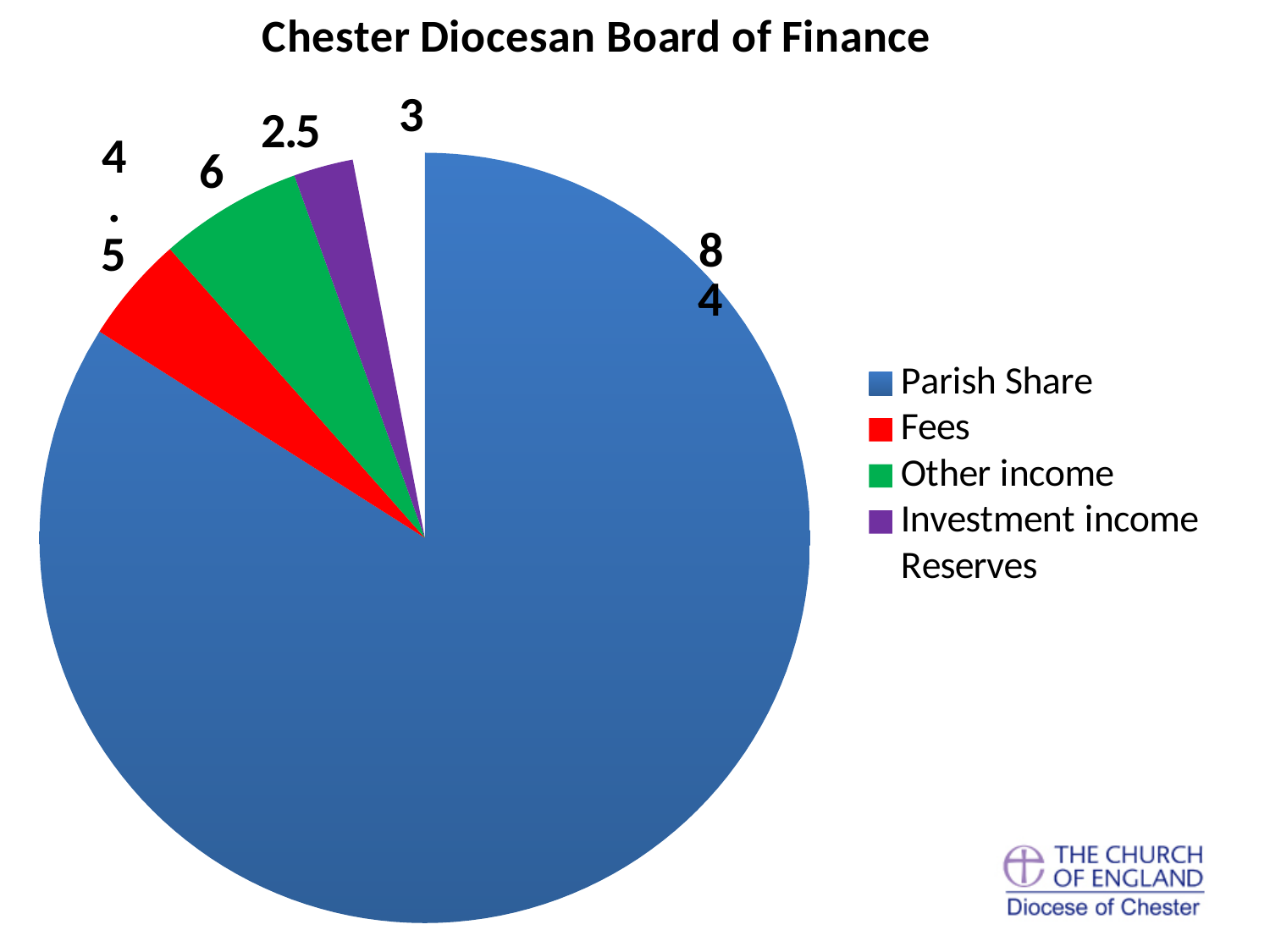
What is the value for Reserves? 3 How many slices does the pie chart have? 5 What is the value for Other income? 6 What kind of chart is shown on the slide? Pie chart Which is larger, the value for Fees or the value for Reserves? Fees What is the title of the chart? Chester Diocesan Board of Finance Which category has the largest slice of the pie? Parish Share What is the difference between the values for Other income and Fees? 1.5 What is the value for Parish Share? 84 What is the value for Investment income? 2.5 Which category has the smallest slice of the pie? Investment income What is the value for Fees? 4.5